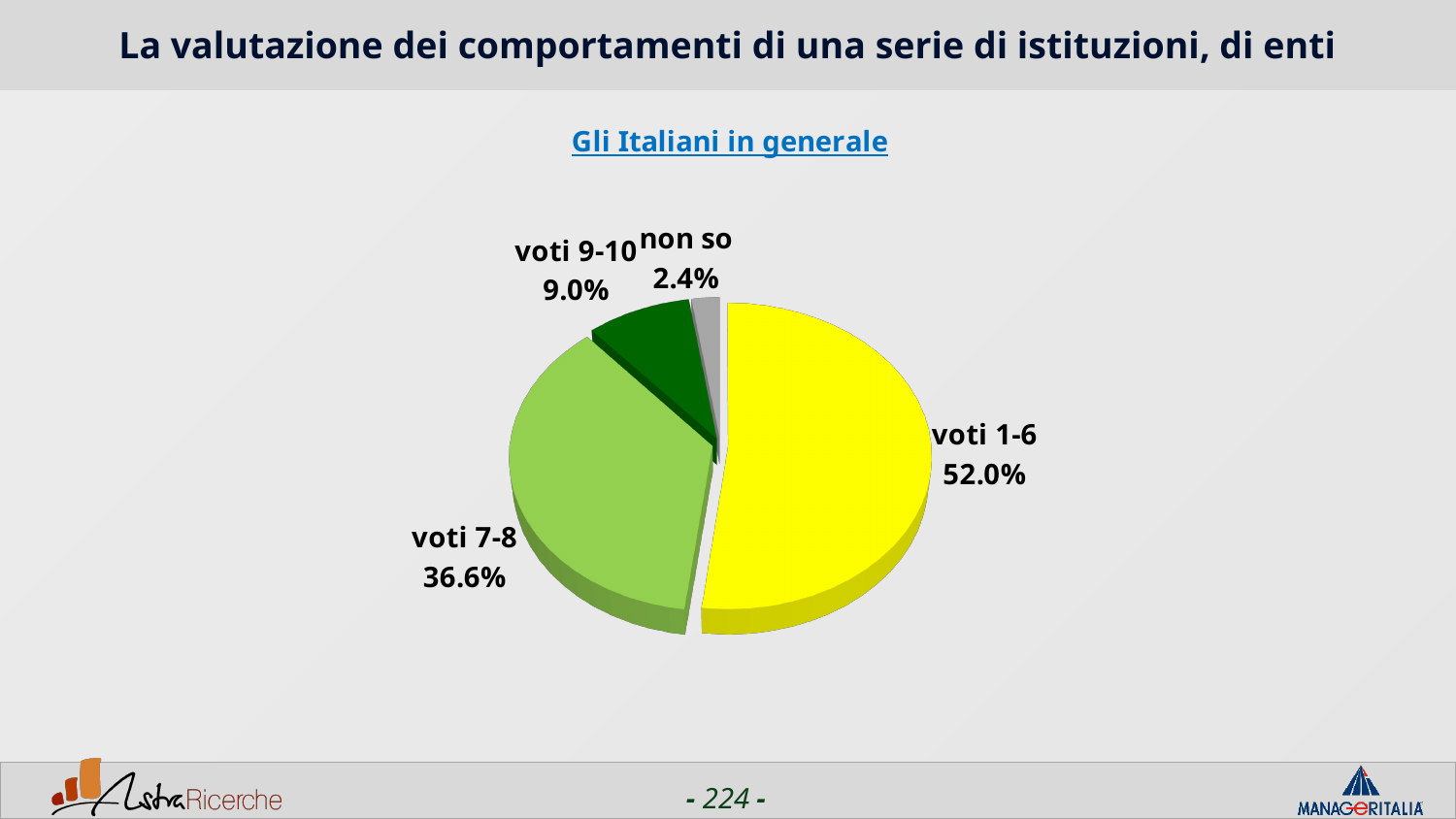
What is the value for "non so"? 2.4% Which is larger, the value for "voti 9-10" or the value for "non so"? voti 9-10 What is the difference between the values for "voti 1-6" and "voti 7-8"? 15.4% Which category has the largest share of the pie? voti 1-6 What is the subtitle shown above the pie chart? Gli Italiani in generale How many slices does the pie chart have? 4 What is the value for "voti 9-10"? 9.0% Which category has the smallest share of the pie? non so What is the combined share of "voti 7-8" and "voti 9-10"? 45.6% What kind of chart is shown on the slide? pie chart What is the value for "voti 7-8"? 36.6% What is the value for "voti 1-6"? 52.0%